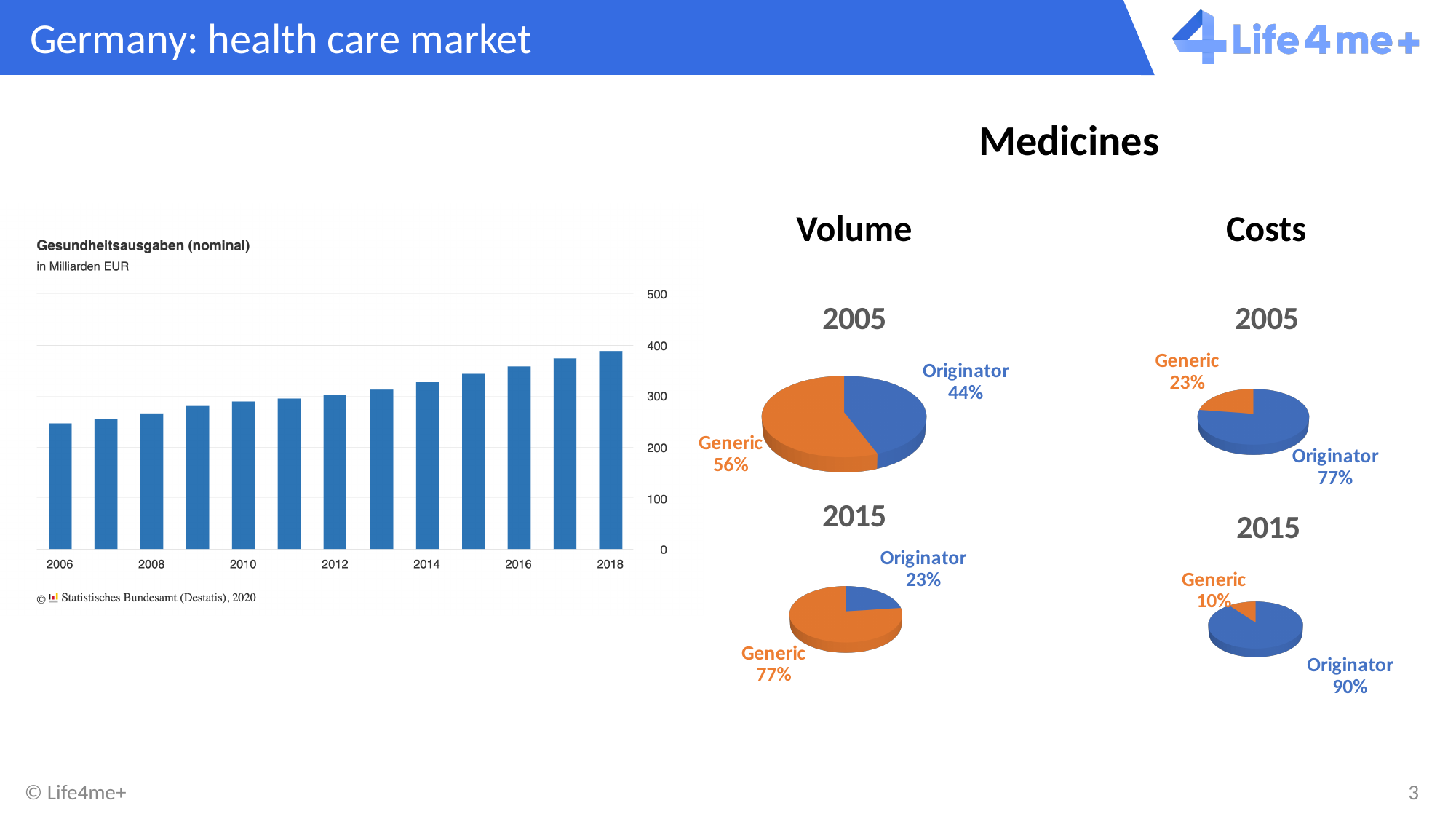
In the Costs 2015 pie chart, what share is Originator? 90% In the Gesundheitsausgaben (nominal) bar chart, do the values rise or fall from 2006 to 2018? rise How many years are plotted in the Gesundheitsausgaben (nominal) bar chart? 13 What kind of chart is the Gesundheitsausgaben (nominal) chart on the left? bar chart In the Gesundheitsausgaben (nominal) bar chart, is the value for 2018 greater or less than 300? greater In the Volume 2005 pie chart, what share is Generic? 56% In the Gesundheitsausgaben (nominal) bar chart, which year has the highest value? 2018 In the Volume 2015 pie chart, what share is Originator? 23% In the Costs 2015 pie chart, what is the difference between the Originator and Generic shares? 80% In the Costs 2005 pie chart, which is larger, Generic or Originator? Originator In the Gesundheitsausgaben (nominal) bar chart, which year has the lowest value? 2006 In the Gesundheitsausgaben (nominal) bar chart, is the value for 2006 greater or less than 300? less